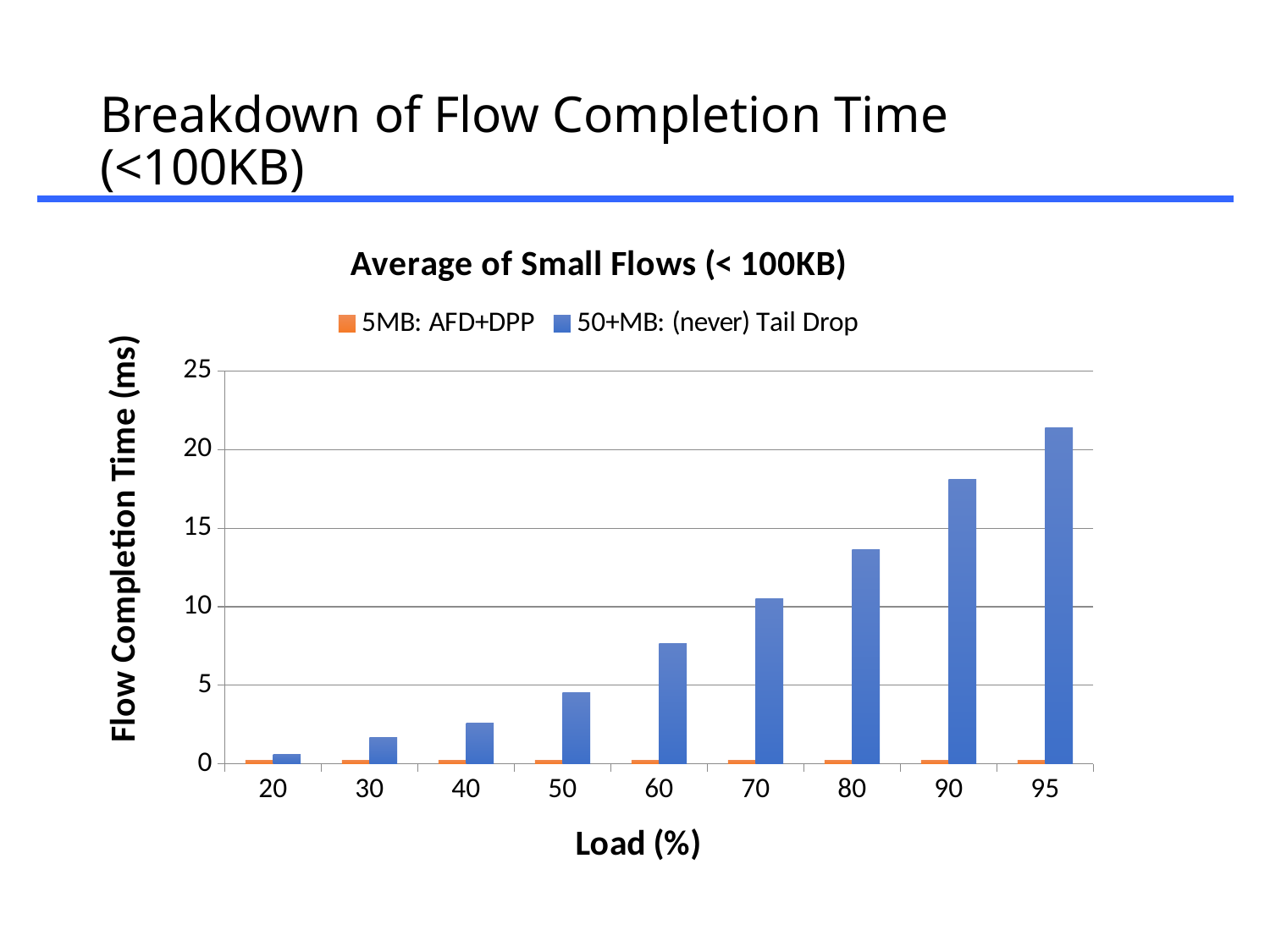
Is the value for 50+MB: (never) Tail Drop at 40% load greater or less than 5? less Do the values for 50+MB: (never) Tail Drop rise or fall as load increases along the x axis? rise Is the value for 50+MB: (never) Tail Drop at 70% load greater or less than 10? greater What is the label of the y axis? Flow Completion Time (ms) Is the value for 50+MB: (never) Tail Drop at 95% load greater or less than 20? greater How many series does the legend list? 2 Which load level has the highest value for the 50+MB: (never) Tail Drop series? 95 Which load level has the lowest value for the 50+MB: (never) Tail Drop series? 20 How many load categories are shown on the x axis? 9 Which is larger at 80% load: the 5MB: AFD+DPP value or the 50+MB: (never) Tail Drop value? 50+MB: (never) Tail Drop What kind of chart is shown on the slide? bar chart What is the title of the chart? Average of Small Flows (< 100KB)